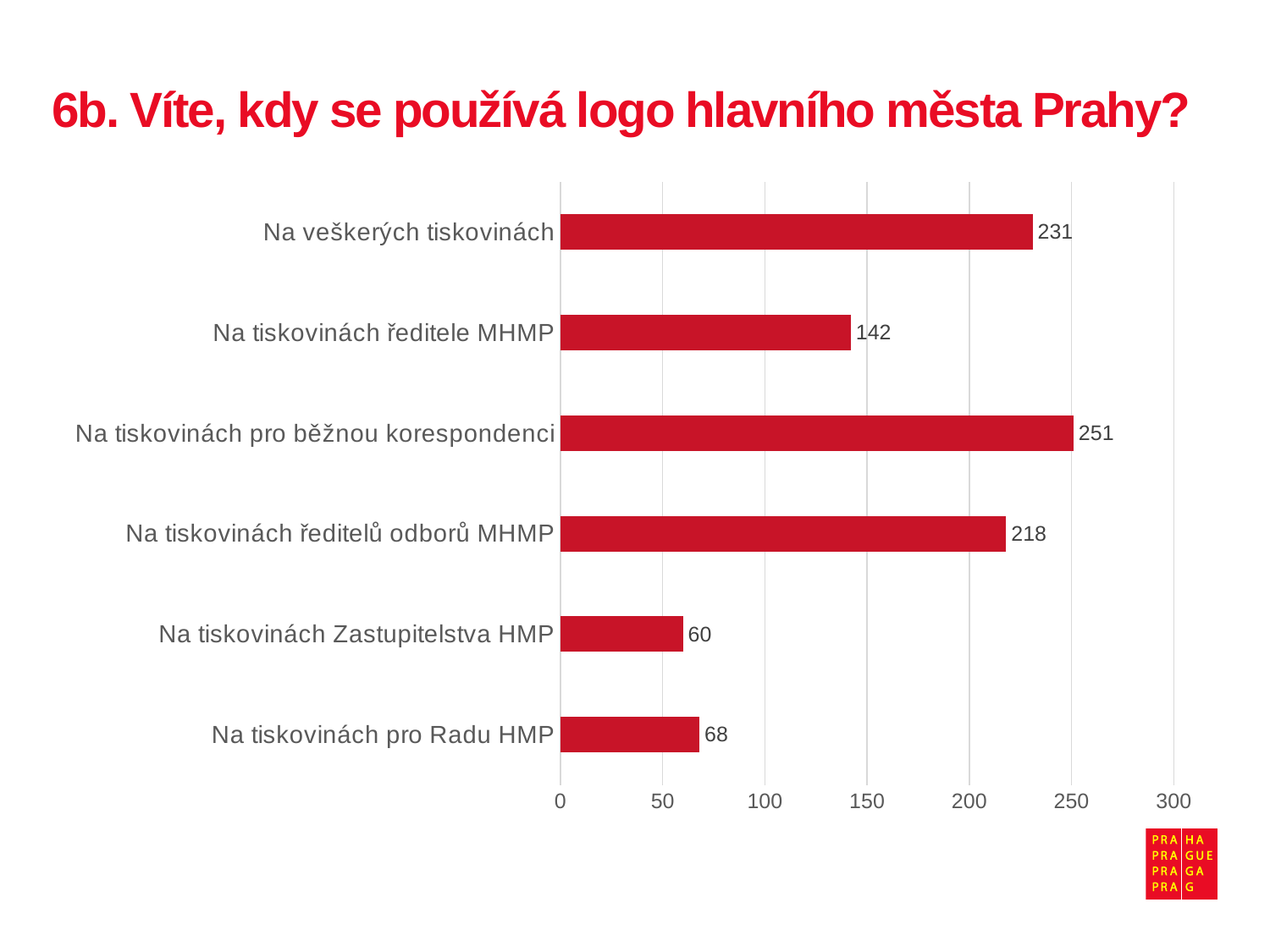
What kind of chart is shown on the slide? bar chart Which category has the highest value? Na tiskovinách pro běžnou korespondenci What is the difference between the values for "Na tiskovinách pro Radu HMP" and "Na tiskovinách Zastupitelstva HMP"? 8 Which category has the lowest value? Na tiskovinách Zastupitelstva HMP What is the value for "Na veškerých tiskovinách"? 231 Is the value for "Na tiskovinách ředitelů odborů MHMP" greater or less than 200? greater What is the difference between the values for "Na tiskovinách pro běžnou korespondenci" and "Na veškerých tiskovinách"? 20 What is the value for "Na tiskovinách pro Radu HMP"? 68 How many categories are shown in the chart? 6 What is the value for "Na tiskovinách ředitele MHMP"? 142 Which is larger: the value for "Na tiskovinách ředitelů odborů MHMP" or the value for "Na tiskovinách ředitele MHMP"? Na tiskovinách ředitelů odborů MHMP What is the title of the slide? 6b. Víte, kdy se používá logo hlavního města Prahy?